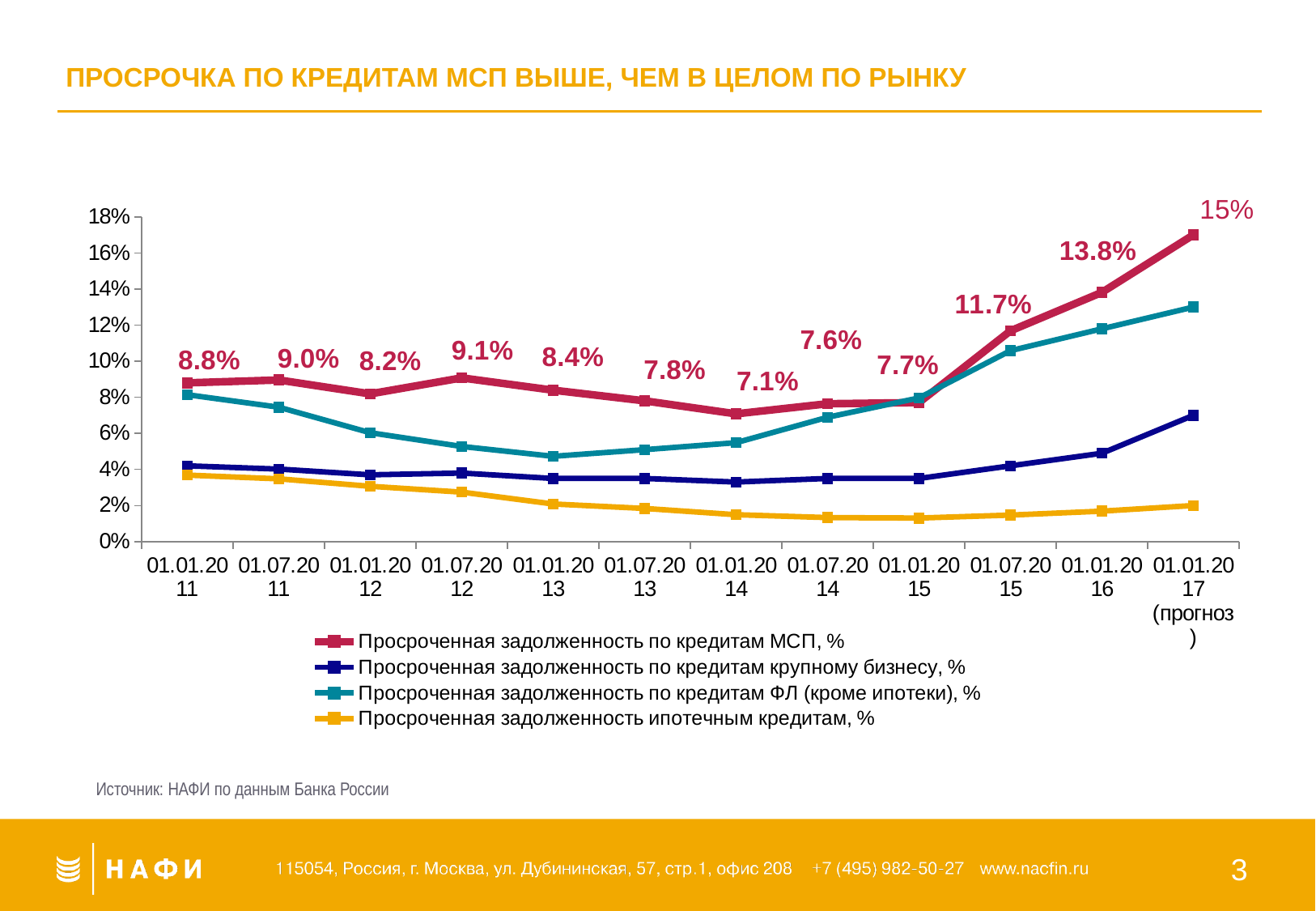
What is the value of 'Просроченная задолженность по кредитам МСП, %' at 01.07.2012? 9.1% At which date is 'Просроченная задолженность по кредитам МСП, %' lowest? 01.01.2014 What is the value of 'Просроченная задолженность по кредитам МСП, %' at 01.01.2016? 13.8% Is the value for 'Просроченная задолженность по кредитам ФЛ (кроме ипотеки), %' at 01.01.2017 greater or less than 12%? greater How many series does the legend list? 4 What colour is the line for 'Просроченная задолженность по кредитам МСП, %'? red What is the difference between the 'Просроченная задолженность по кредитам МСП, %' values at 01.01.2016 and 01.07.2015? 2.1% How many dates are shown along the x axis? 12 What kind of chart is shown on the slide? line chart Which is larger for 'Просроченная задолженность по кредитам МСП, %': the value at 01.07.2011 or at 01.01.2012? 01.07.2011 Does 'Просроченная задолженность ипотечным кредитам, %' rise or fall from 01.01.2011 to 01.01.2015? fall What is the value of 'Просроченная задолженность по кредитам МСП, %' at 01.01.2011? 8.8%